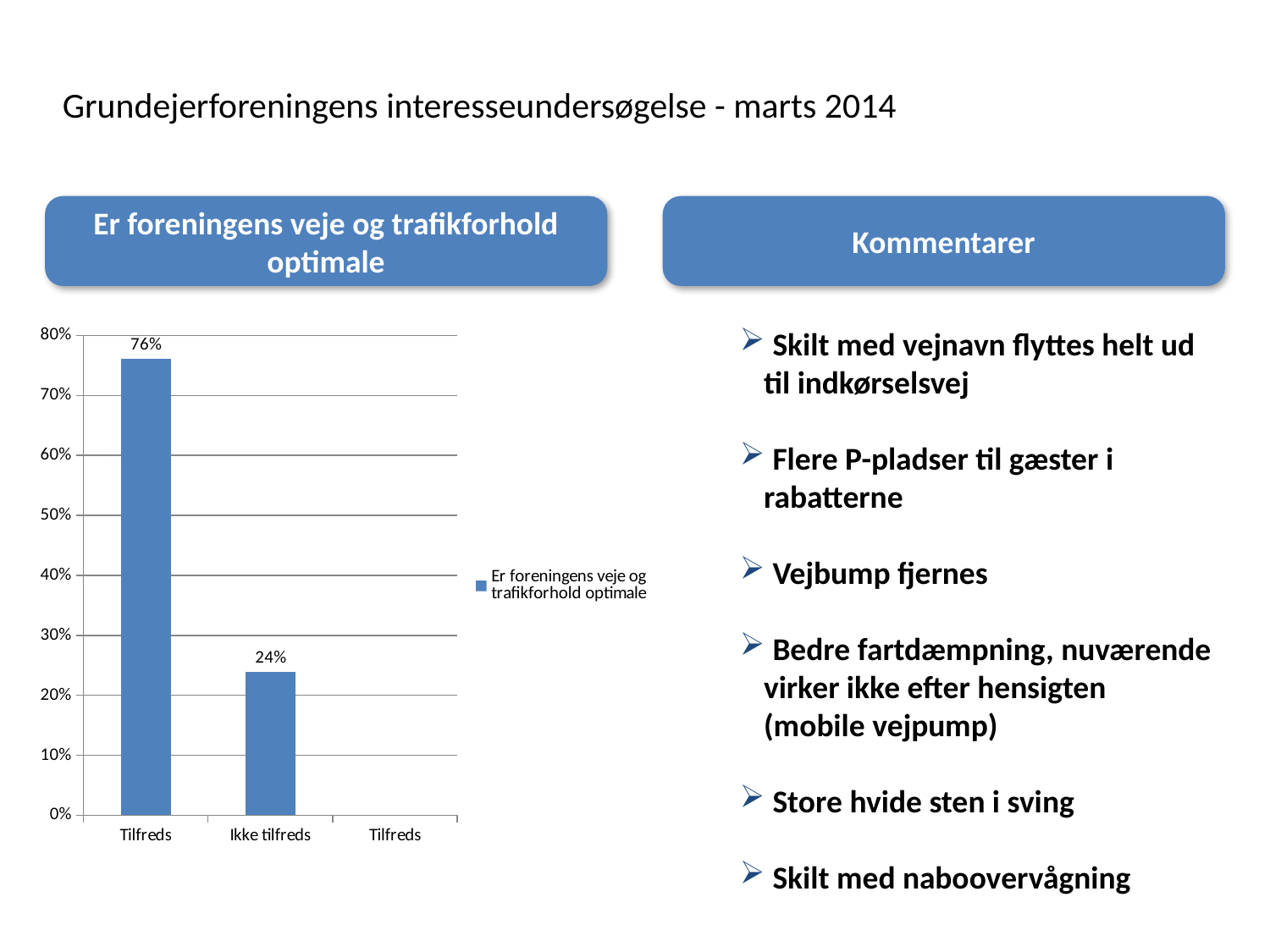
What is the legend entry of the chart? Er foreningens veje og trafikforhold optimale How many series does the chart legend list? 1 Which of the two plotted bars has the lowest value? Ikke tilfreds Which is larger, the value for Tilfreds or the value for Ikke tilfreds? Tilfreds What kind of chart is shown on the slide? Bar chart What is the value for Ikke tilfreds in the chart? 24% Is the value for Ikke tilfreds greater or less than 30%? less How many bars are plotted in the chart? 2 Which category has the highest value in the chart? Tilfreds Is the value for Tilfreds greater or less than 70%? greater What is the value for Tilfreds in the chart? 76% What is the difference between the values for Tilfreds and Ikke tilfreds? 52%